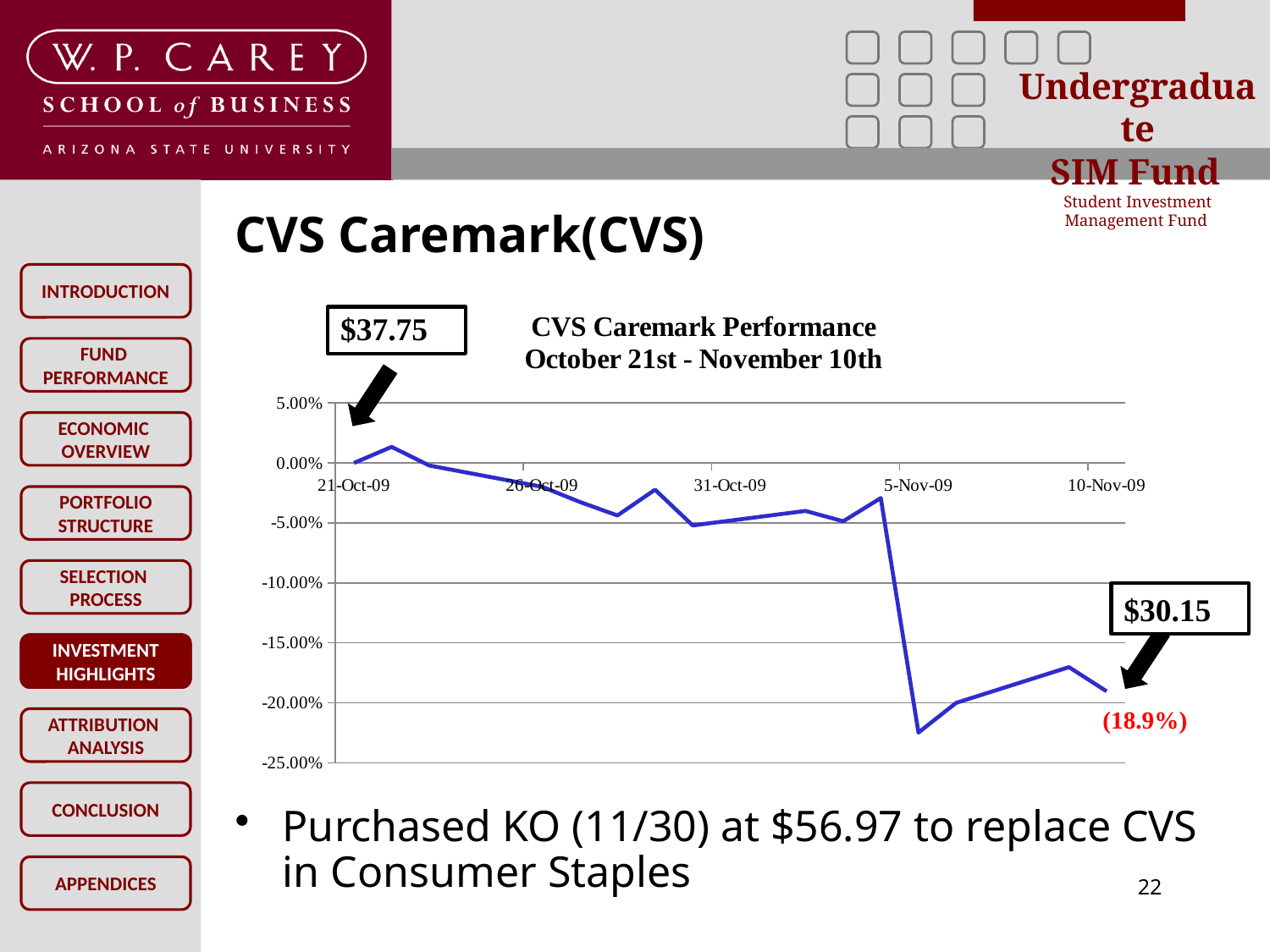
What price is annotated at the end of the line on 10-Nov-09? $30.15 Is the value on 5-Nov-09 greater or less than -5.00%? greater Is the value on 10-Nov-09 greater or less than -15.00%? less What is the last date shown on the x axis of the chart? 10-Nov-09 What kind of chart is shown on the slide? line chart Overall, does the line rise or fall from 21-Oct-09 to 10-Nov-09? fall What is the title of the chart? CVS Caremark Performance October 21st - November 10th What is the first date shown on the x axis of the chart? 21-Oct-09 Is the lowest point on the line greater or less than -20.00%? less What percentage change is printed in red near the end of the line? (18.9%) What price is annotated at the start of the line on 21-Oct-09? $37.75 What is the lowest value shown on the y axis? -25.00%